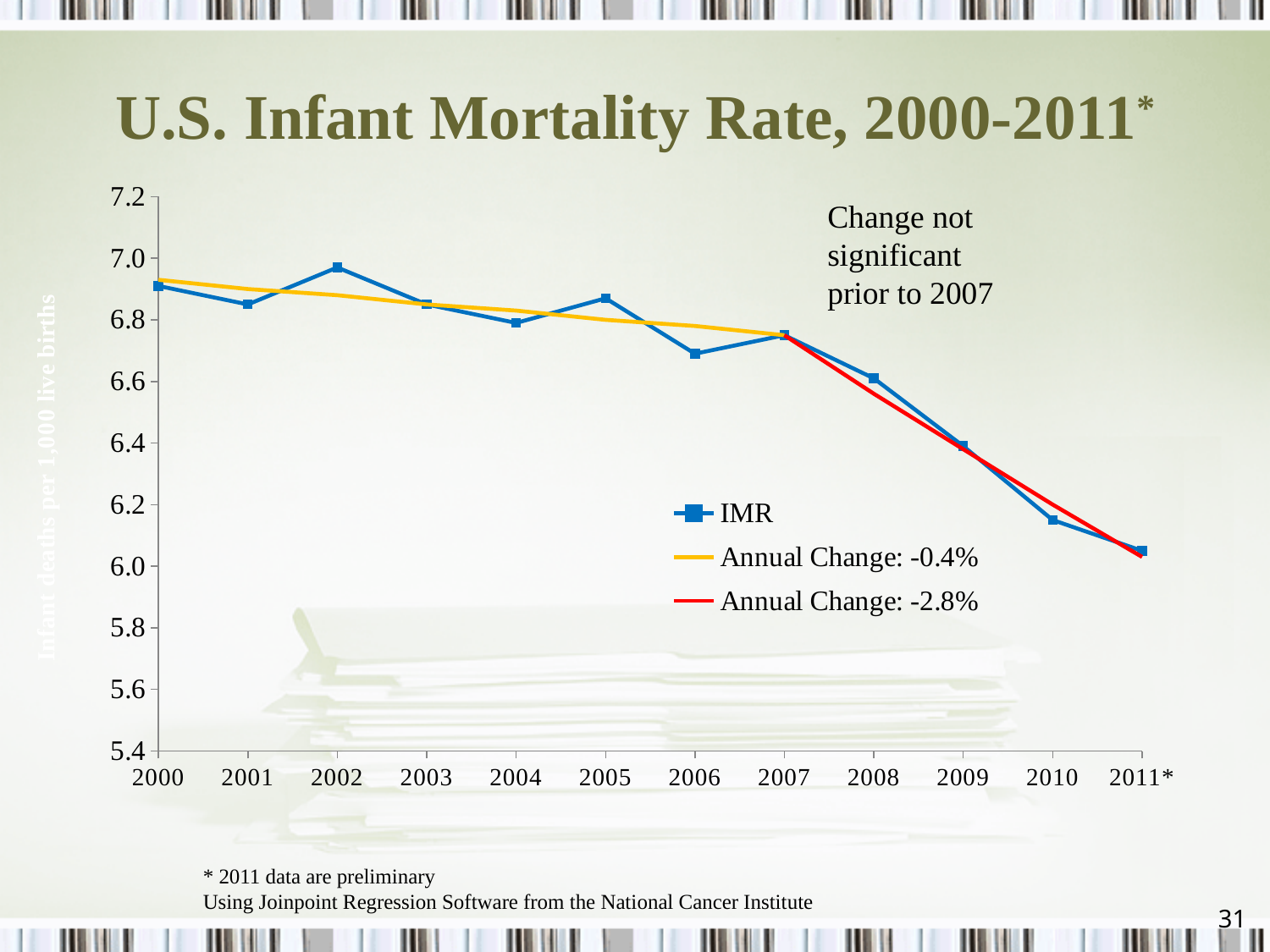
Which year has the highest IMR value? 2002 How many years are plotted along the x axis? 12 Which year has the lowest IMR value? 2011* Is the IMR value for 2008 greater or less than 6.4? greater Which year has the larger IMR value, 2000 or 2011*? 2000 What is the title of the chart? U.S. Infant Mortality Rate, 2000-2011* How many series does the legend list? 3 Is the IMR value for 2000 greater or less than 6.8? greater Is the IMR value for 2011* greater or less than 6.2? less Does the IMR generally rise or fall from 2007 to 2011? fall What kind of chart is shown on the slide? line chart